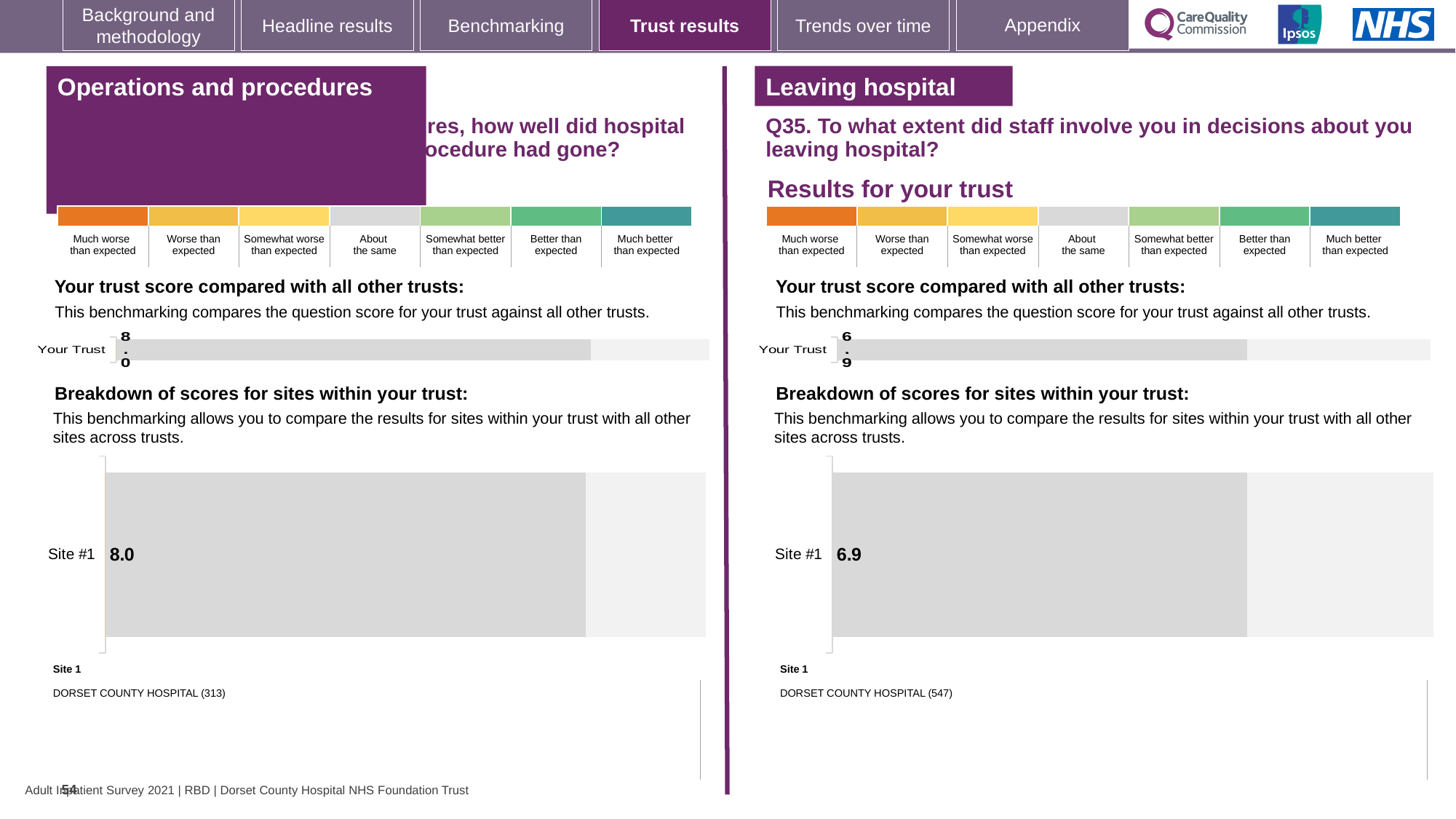
In the Operations and procedures 'Breakdown of scores for sites within your trust' chart, what is the score for Site #1? 8.0 In the Leaving hospital 'Breakdown of scores for sites within your trust' chart, what is the score for Site #1? 6.9 How many sites are shown in the Leaving hospital 'Breakdown of scores for sites within your trust' chart? 1 Which section shows a higher Site #1 score: Operations and procedures or Leaving hospital? Operations and procedures According to the site key below the Operations and procedures breakdown chart, which hospital is Site 1? DORSET COUNTY HOSPITAL What type of chart is used to show the Site #1 score in the Leaving hospital section? Bar chart What is the difference between the Site #1 score in the Operations and procedures chart and the Site #1 score in the Leaving hospital chart? 1.1 Which section shows a higher Your Trust score: Operations and procedures or Leaving hospital? Operations and procedures How many sites are shown in the Operations and procedures 'Breakdown of scores for sites within your trust' chart? 1 In the Leaving hospital section, is the Your Trust score greater or less than 8? less In the Operations and procedures section, what is the score shown for Your Trust in the 'Your trust score compared with all other trusts' chart? 8.0 In the Leaving hospital section, what is the score shown for Your Trust in the 'Your trust score compared with all other trusts' chart? 6.9